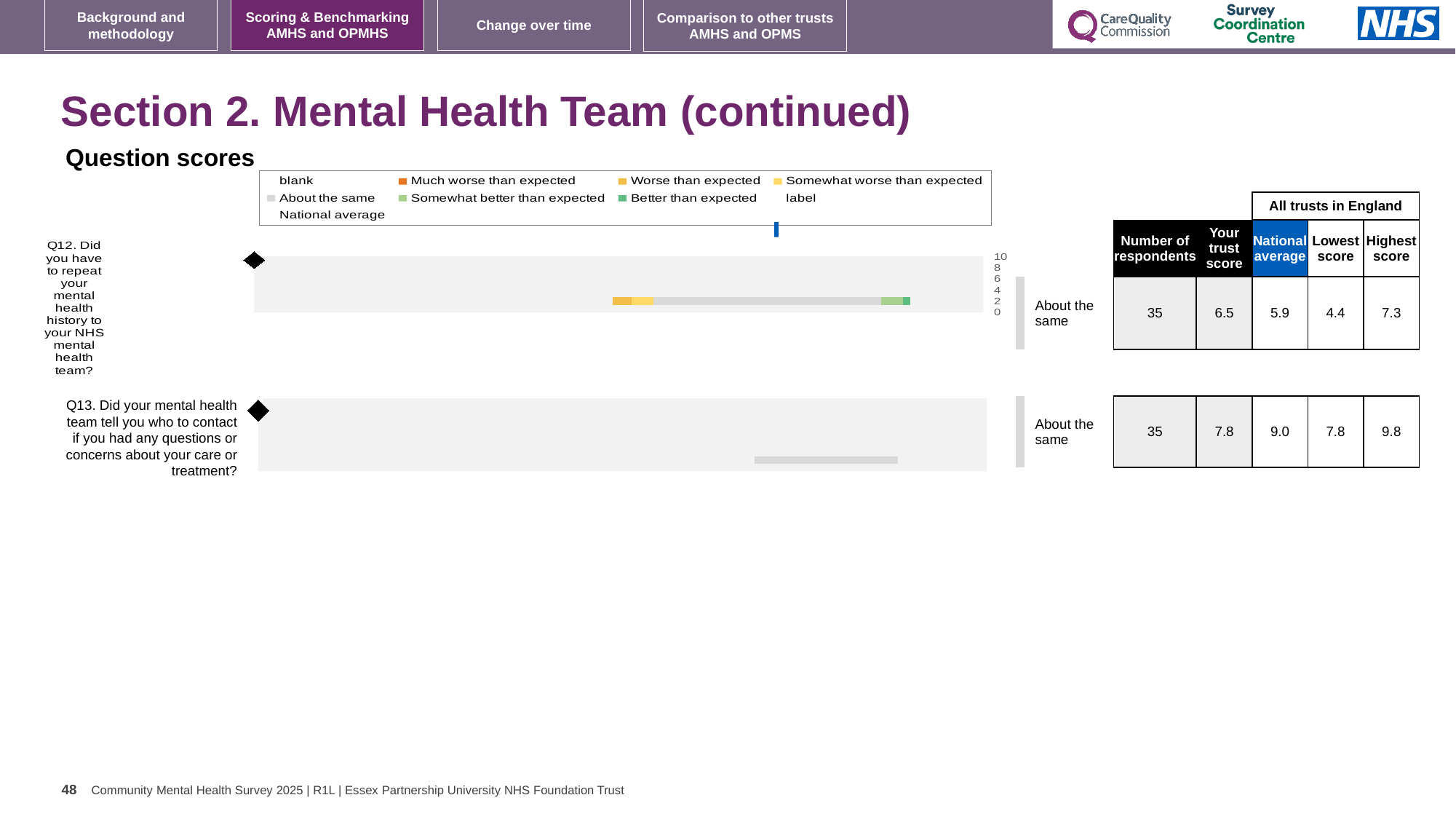
For Q13, what is the highest score among all trusts in England? 9.8 For Q12 (repeating your mental health history), what is your trust score? 6.5 What kind of chart is used to show the question scores? Bar chart For Q13, what is the difference between the highest score and the lowest score across all trusts? 2.0 How many questions are charted on this slide? 2 For Q12, what is the difference between the highest score and the lowest score across all trusts? 2.9 How many respondents answered Q13? 35 For Q13, which is larger: your trust score or the national average? National average For Q12, what is the lowest score among all trusts in England? 4.4 What benchmark category is shown for Q12? About the same For Q12, which is larger: your trust score or the national average? Your trust score For Q13 (being told who to contact), what is the national average score? 9.0